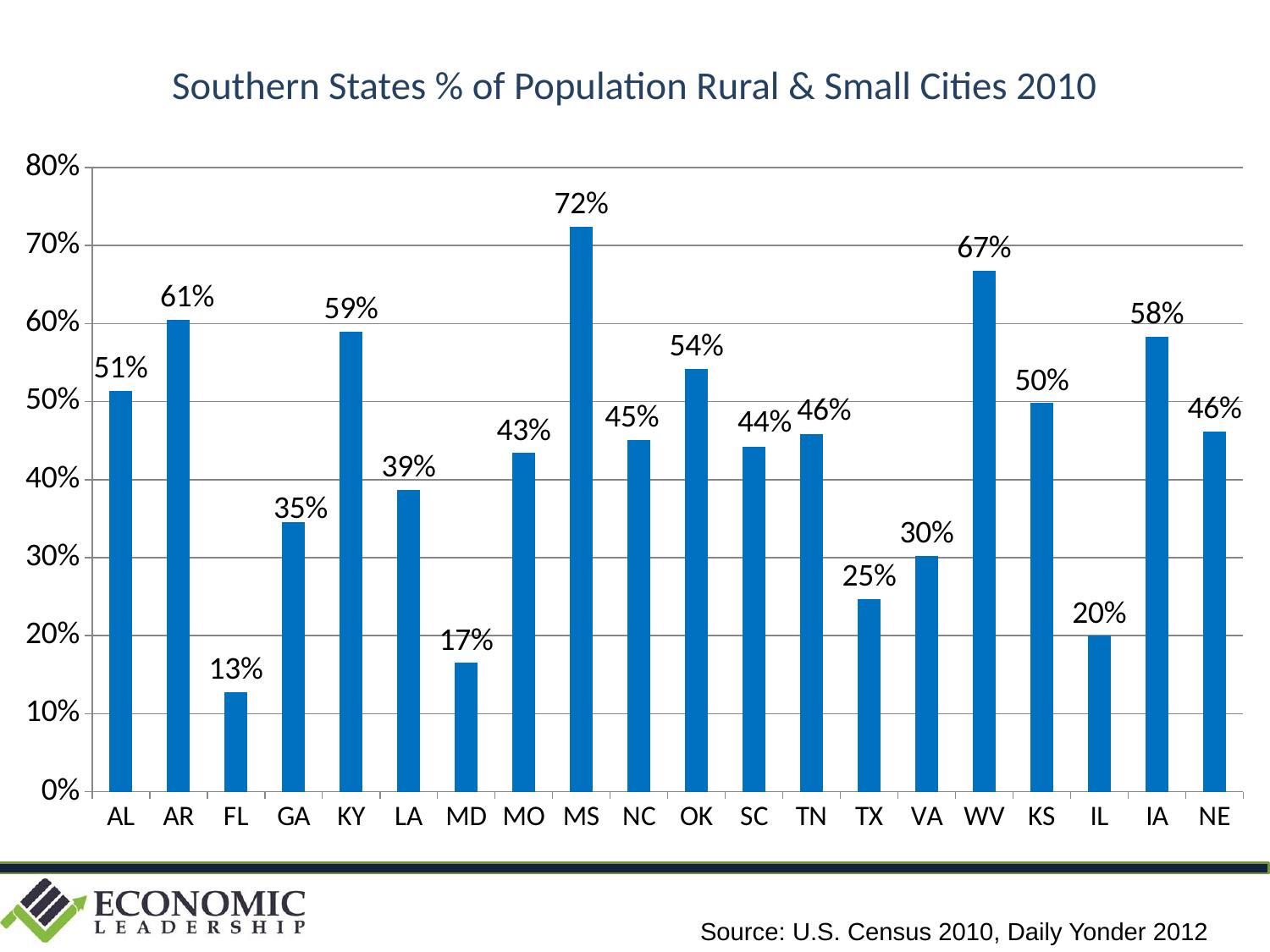
What is the value for FL? 13% What kind of chart is this? bar chart What is the value for MS? 72% Which is larger, the value for OK or the value for NC? OK Which state has the highest value? MS What is the difference between the values for AR and KY? 2% What is the value for WV? 67% What is the title of the chart? Southern States % of Population Rural & Small Cities 2010 Is the value for TX greater or less than 30%? less How many states are shown on the x axis? 20 Which state has the lowest value? FL What is the difference between the values for MS and FL? 59%